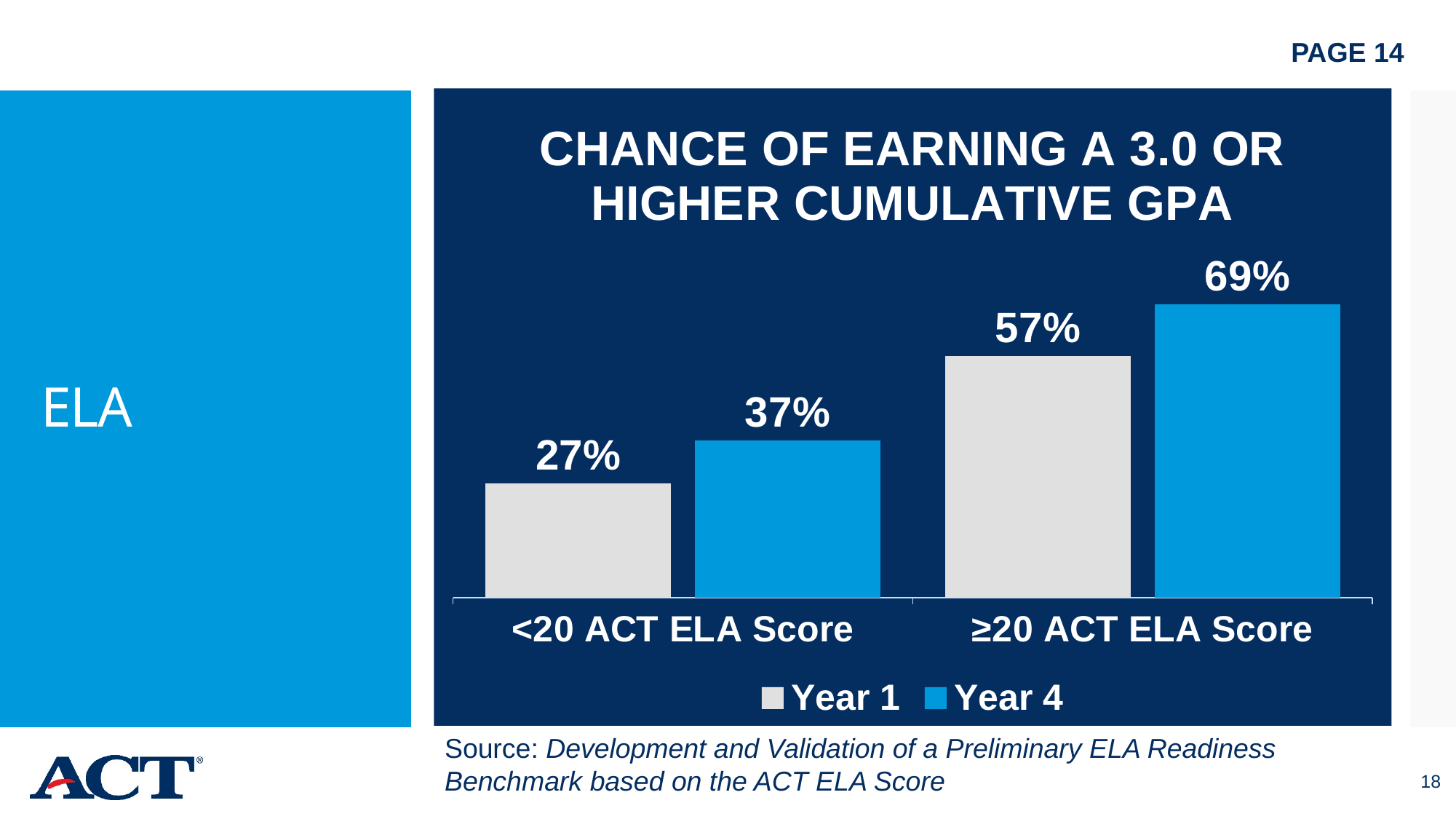
Which bar has the highest value on the chart? Year 4, ≥20 ACT ELA Score How many series does the legend list? 2 What is the difference between the Year 4 and Year 1 values for ≥20 ACT ELA Score? 12% What is the Year 4 value for ≥20 ACT ELA Score? 69% What kind of chart is shown on the slide? Bar chart Which is larger: the Year 4 value for <20 ACT ELA Score or the Year 1 value for ≥20 ACT ELA Score? Year 1 value for ≥20 ACT ELA Score What is the Year 1 value for <20 ACT ELA Score? 27% What is the Year 1 value for ≥20 ACT ELA Score? 57% Which bar has the lowest value on the chart? Year 1, <20 ACT ELA Score What is the Year 4 value for <20 ACT ELA Score? 37% What is the difference between the Year 4 and Year 1 values for <20 ACT ELA Score? 10% How many categories are shown on the x axis? 2